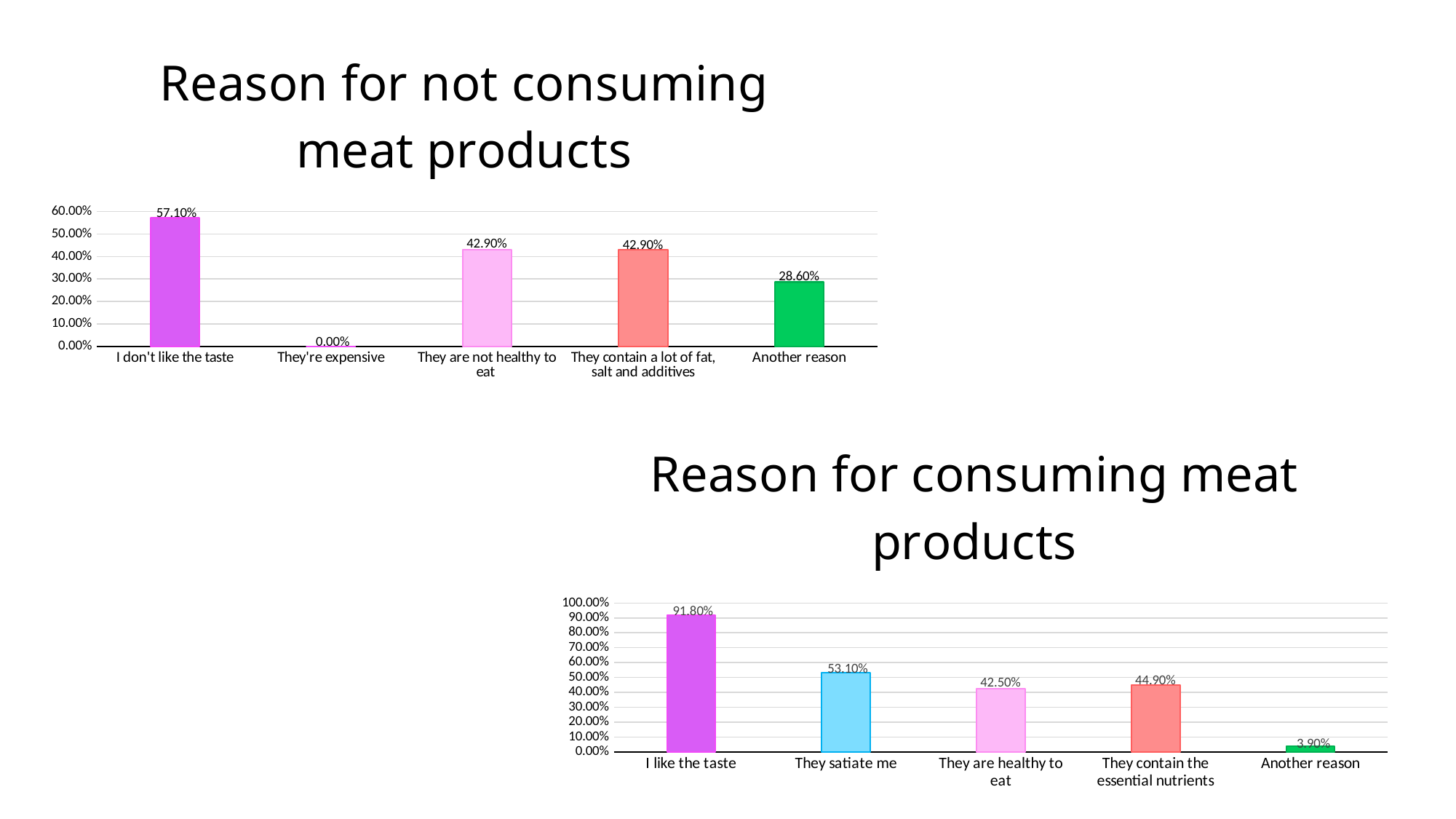
In the 'Reason for not consuming meat products' chart, which category has the lowest value? They're expensive How many categories are shown in the 'Reason for not consuming meat products' chart? 5 In the 'Reason for consuming meat products' chart, which is larger: 'They are healthy to eat' or 'They contain the essential nutrients'? They contain the essential nutrients In the 'Reason for consuming meat products' chart, what is the difference between 'I like the taste' and 'They satiate me'? 38.70% What type of chart is the 'Reason for consuming meat products' chart? Bar chart In the 'Reason for consuming meat products' chart, what is the value for 'They satiate me'? 53.10% In the 'Reason for not consuming meat products' chart, what is the value for 'Another reason'? 28.60% In the 'Reason for consuming meat products' chart, which category has the highest value? I like the taste In the 'Reason for consuming meat products' chart, what is the value for 'They contain the essential nutrients'? 44.90% In the 'Reason for not consuming meat products' chart, what is the difference between 'I don't like the taste' and 'Another reason'? 28.50% In the 'Reason for not consuming meat products' chart, what is the value for 'I don't like the taste'? 57.10% In the 'Reason for not consuming meat products' chart, which category has the highest value? I don't like the taste